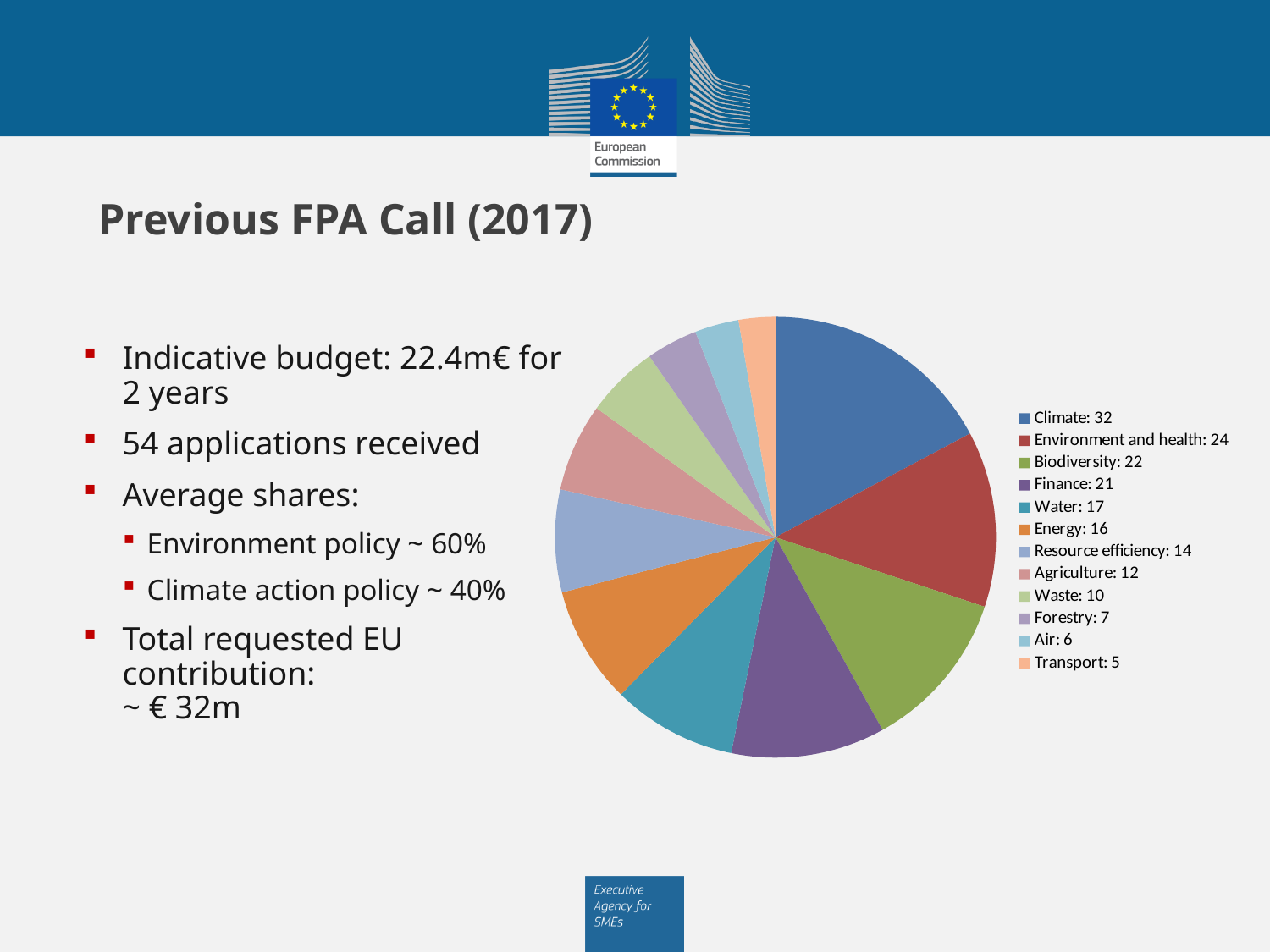
What is the value for Resource efficiency in the pie chart? 14 Which is larger in the pie chart, Energy or Agriculture? Energy What colour is the Climate slice in the pie chart? blue What is the difference between the values for Water and Air? 11 Which is larger in the pie chart, Biodiversity or Finance? Biodiversity What kind of chart is shown on the slide? pie chart Which category has the smallest slice in the pie chart? Transport What is the value for Climate in the pie chart? 32 What is the value for Forestry in the pie chart? 7 Which category has the largest slice in the pie chart? Climate How many categories does the pie chart show? 12 What is the difference between the values for Climate and Environment and health? 8